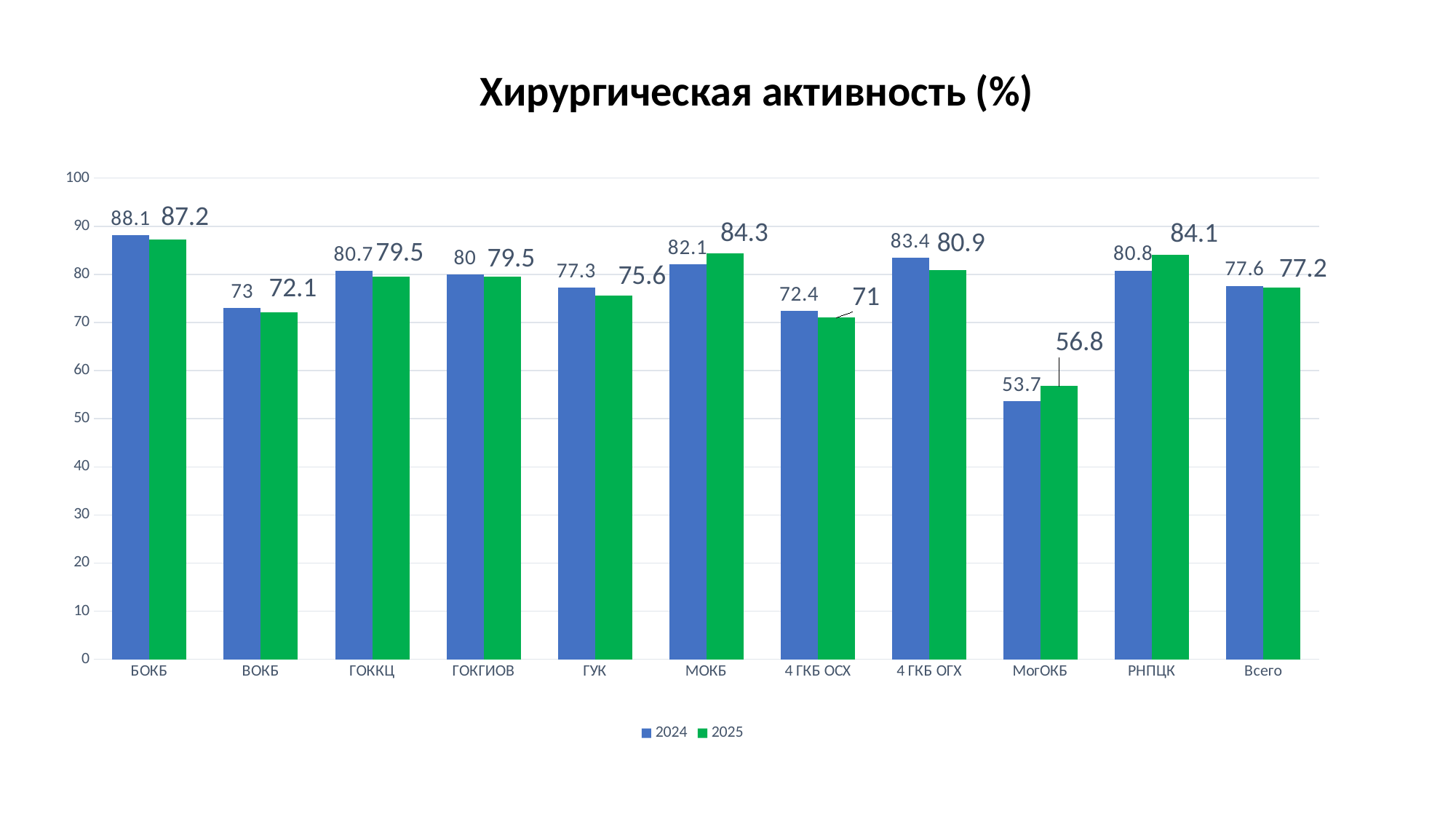
Which category has the lowest 2024 value? МогОКБ Which is larger for 4 ГКБ ОГХ, the 2024 value or the 2025 value? 2024 Which category has the highest 2025 value? БОКБ How many categories are shown on the x axis? 11 What is the 2025 value for МогОКБ? 56.8 How many series does the legend list? 2 What kind of chart is shown? bar chart What is the title of the chart? Хирургическая активность (%) What is the 2025 value for Всего? 77.2 What is the 2024 value for БОКБ? 88.1 Is the 2025 value for МогОКБ greater or less than 60? less What is the difference between the 2025 and 2024 values for МОКБ? 2.2